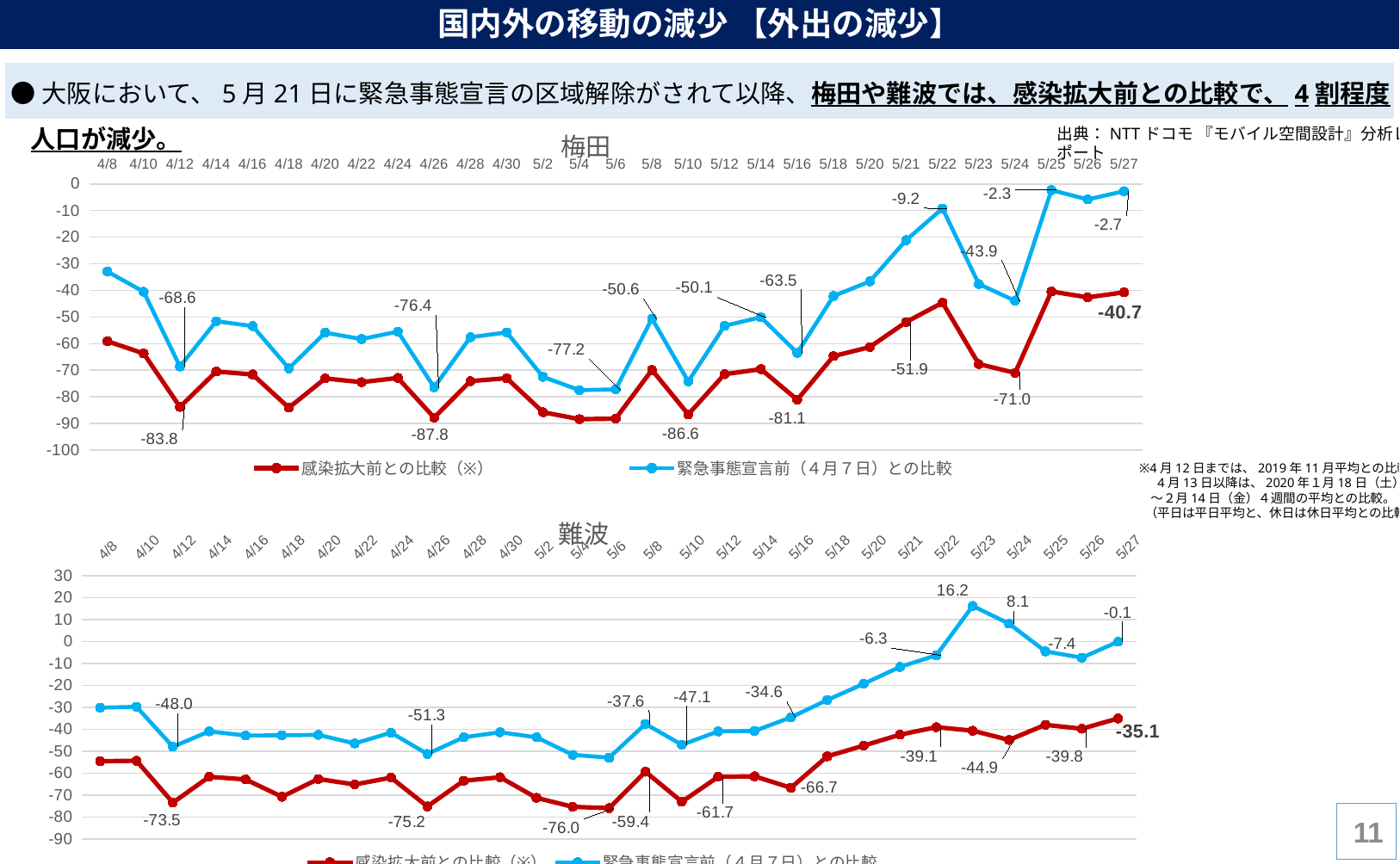
In the 難波 chart, what is the value of 感染拡大前との比較 on 5/27? -35.1 In the 難波 chart, what is the difference between the 緊急事態宣言前（4月7日）との比較 values on 5/23 (16.2) and 5/24 (8.1)? 8.1 In the 梅田 chart, what is the difference between the 感染拡大前との比較 values on 5/27 (-40.7) and 4/12 (-83.8)? 43.1 On 5/27, which is higher for 感染拡大前との比較: the 梅田 chart or the 難波 chart? 難波 In the 梅田 chart, what is the value of 緊急事態宣言前（4月7日）との比較 on 5/25? -2.3 In the 梅田 chart, is the value of 感染拡大前との比較 on 4/8 greater or less than -50? less In the 梅田 chart, what is the value of 感染拡大前との比較 on 5/27? -40.7 In the 難波 chart, on which date does 緊急事態宣言前（4月7日）との比較 reach its highest value? 5/23 What type of chart is the 梅田 chart? line chart In the 難波 chart, which series is drawn in red? 感染拡大前との比較（※） In the 難波 chart, what is the value of 緊急事態宣言前（4月7日）との比較 on 5/23? 16.2 How many series does the legend of the 梅田 chart list? 2